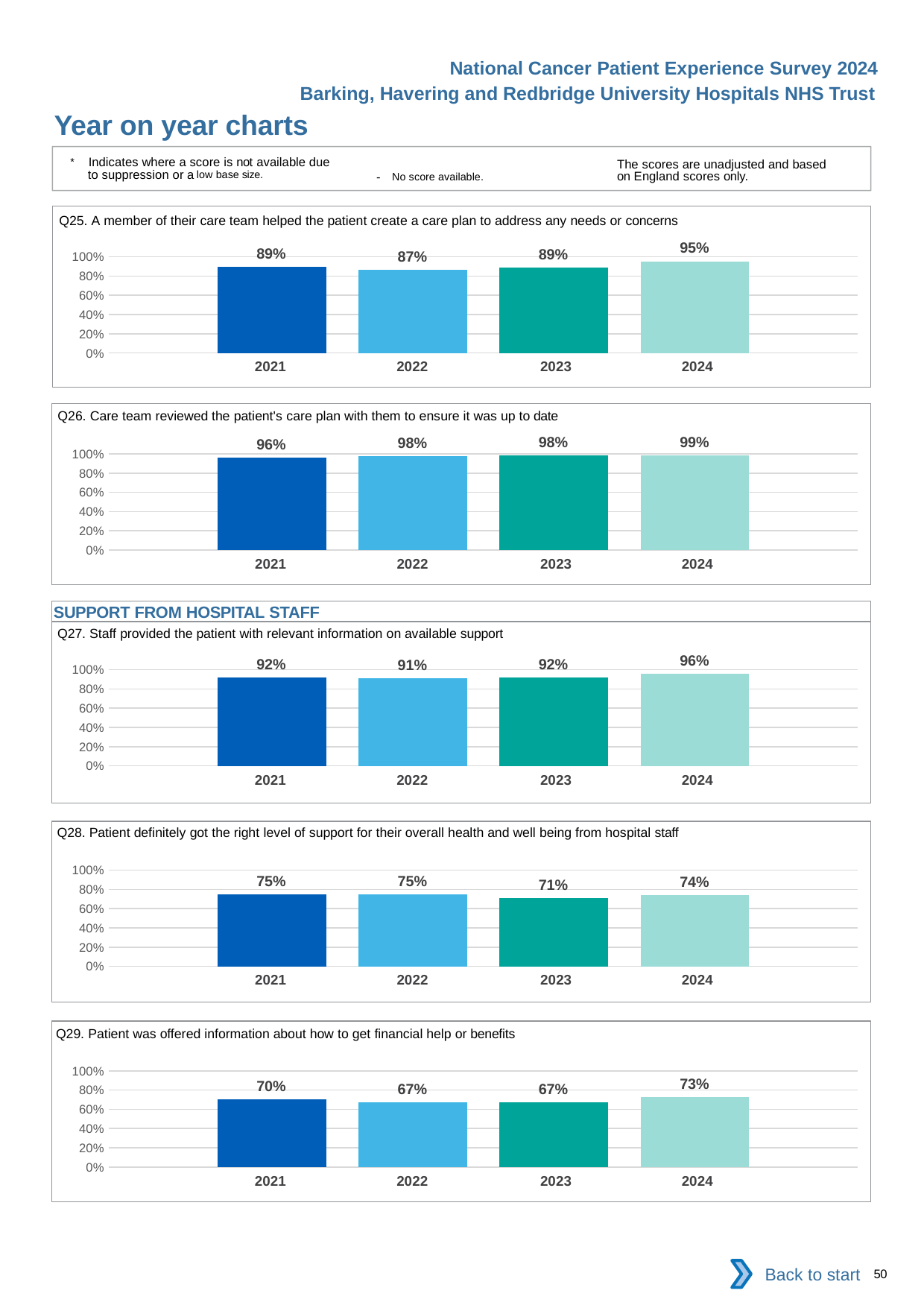
How many years are shown on the x axis of the Q25 chart? 4 What kind of chart is the Q26 chart (care team reviewed the care plan)? bar chart In the Q29 chart (information about financial help or benefits), which year has the highest value? 2024 In the Q28 chart (right level of support for overall health and well being), which year has the lowest value? 2023 What is the section heading shown above the Q27 chart? SUPPORT FROM HOSPITAL STAFF In the Q28 chart (right level of support for overall health and well being), is the value for 2021 larger or smaller than the value for 2024? larger In the Q26 chart (care team reviewed the care plan), which year has the lowest value? 2021 In the Q29 chart (information about financial help or benefits), what is the value for 2021? 70% In the Q27 chart (relevant information on available support), what is the difference between the 2024 and 2022 values? 5% In the Q25 chart (care plan to address needs or concerns), what is the value for 2024? 95% In the Q26 chart (care team reviewed the care plan), what is the value for 2024? 99% In the Q25 chart (care plan to address needs or concerns), what is the difference between the 2024 and 2023 values? 6%